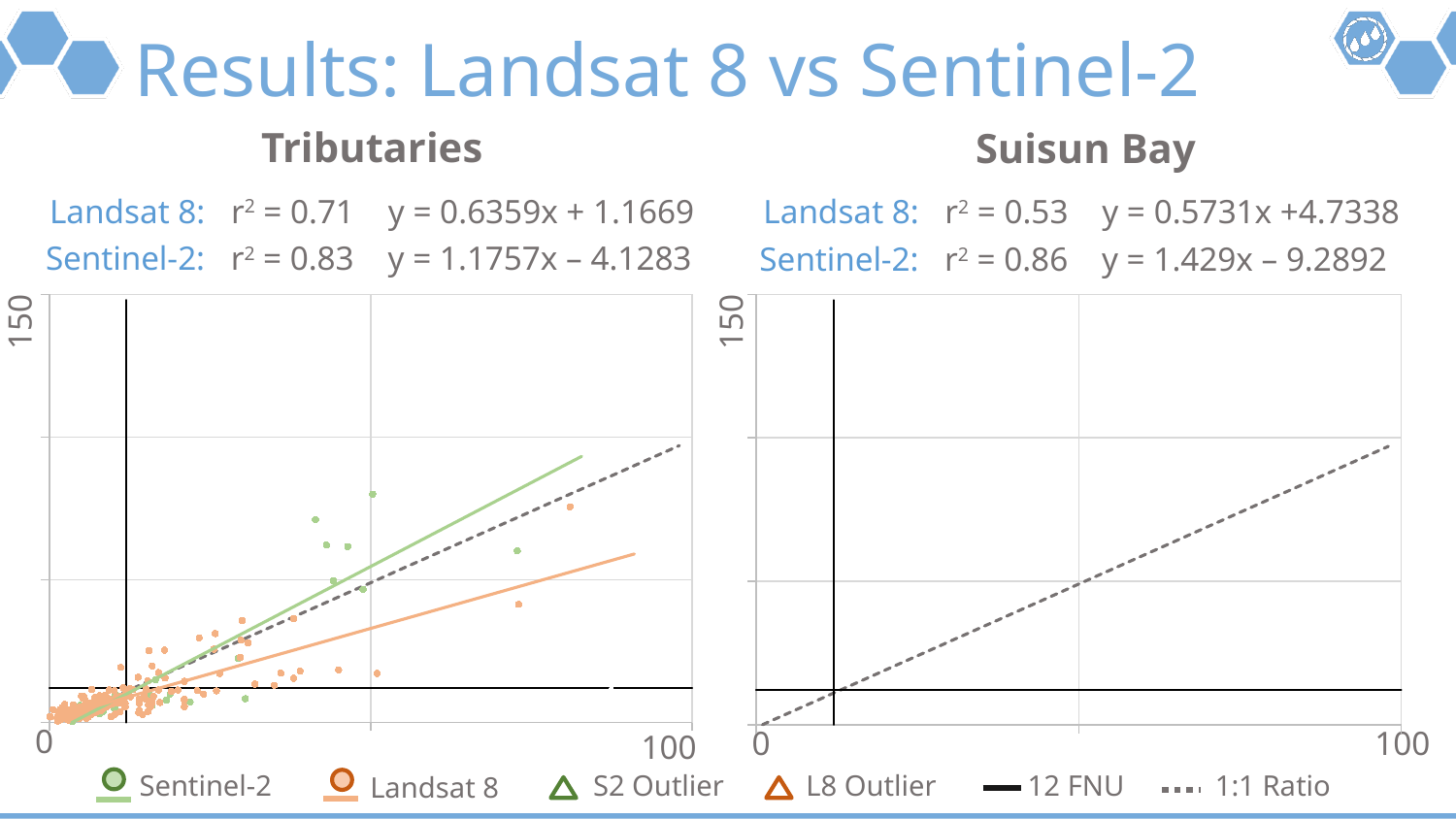
In the Suisun Bay chart, what is the difference between the Sentinel-2 r² and the Landsat 8 r²? 0.33 In the Tributaries chart, which has the higher r², Landsat 8 or Sentinel-2? Sentinel-2 In the Suisun Bay chart, what is the r² value for Sentinel-2? 0.86 In the Tributaries chart, what is the r² value for Landsat 8? 0.71 What kind of chart is the Tributaries chart? scatter chart In the Tributaries chart, what is the r² value for Sentinel-2? 0.83 In the Suisun Bay chart, what is the r² value for Landsat 8? 0.53 What is the highest value labelled on the y axis of the Suisun Bay chart? 150 How many entries does the legend at the bottom of the slide list? 6 Which legend entry is drawn as a dashed line? 1:1 Ratio In the Tributaries chart, which fitted line is steeper, the Sentinel-2 line or the Landsat 8 line? Sentinel-2 In the Tributaries chart, do the plotted points generally rise or fall as the x-axis value increases? rise